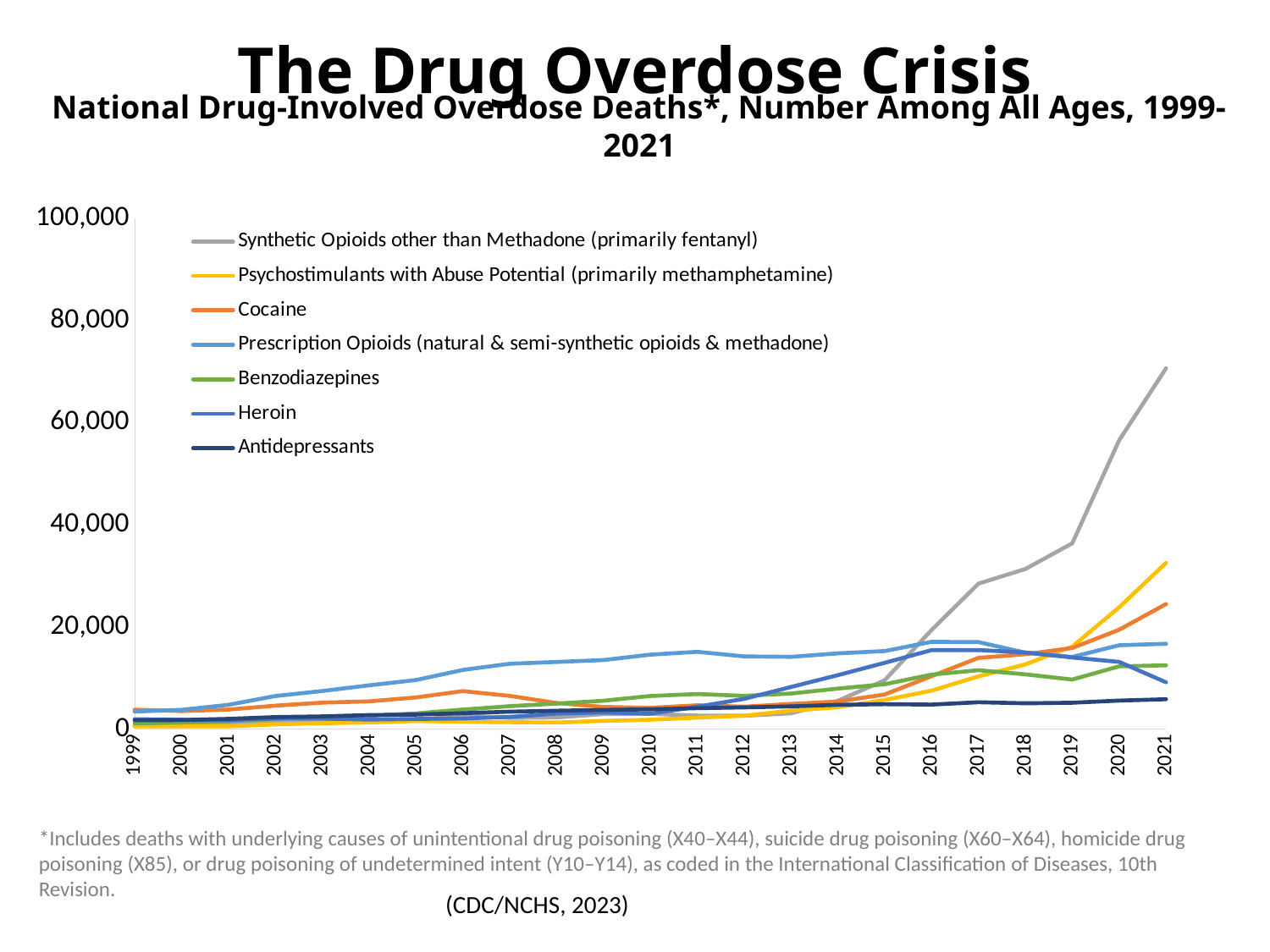
Is the value for Synthetic Opioids other than Methadone in 2021 greater or less than 60,000? greater Is the value for Heroin in 2021 greater or less than 20,000? less What colour is the line for Cocaine in the legend? orange What is the title of the chart? National Drug-Involved Overdose Deaths*, Number Among All Ages, 1999-2021 Which series has the highest value in 2021? Synthetic Opioids other than Methadone (primarily fentanyl) Which series has the lowest value in 2021? Antidepressants Is the value for Psychostimulants with Abuse Potential in 2021 greater or less than 20,000? greater Does the Synthetic Opioids other than Methadone series rise or fall from 2013 to 2021? rise Which is larger in 2021, the value for Cocaine or the value for Antidepressants? Cocaine What kind of chart is shown on the slide? line chart How many years are plotted along the x axis? 23 How many series does the legend list? 7